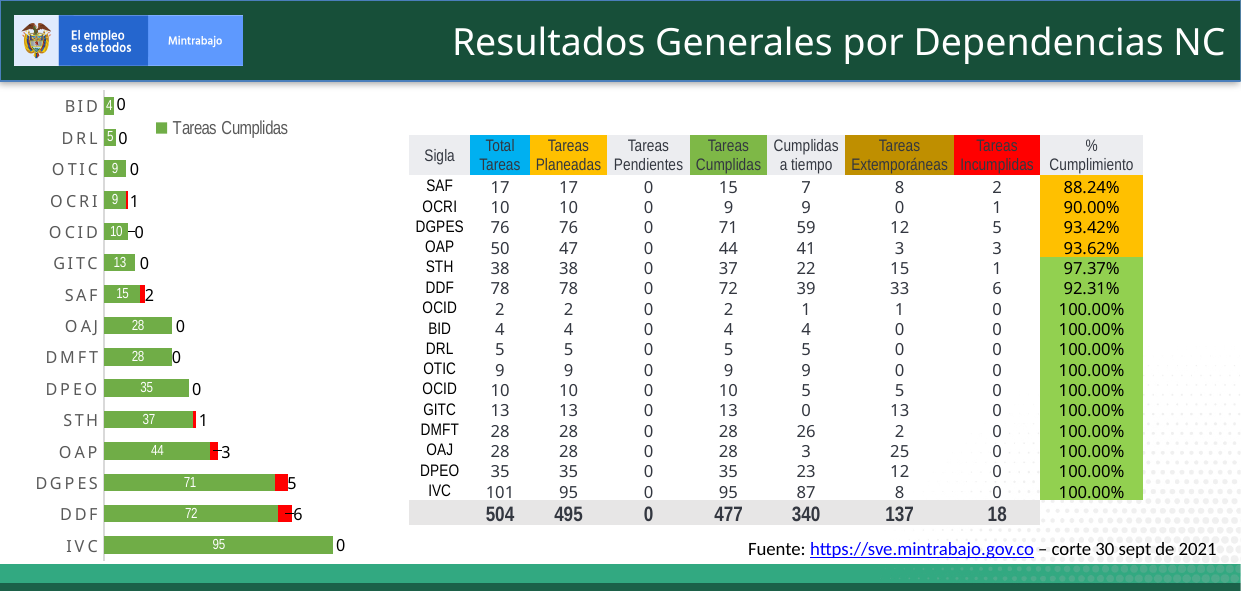
In the bar chart, what is the Tareas Cumplidas value for IVC? 95 In the bar chart, what is the Tareas Cumplidas value for STH? 37 How many series does the legend of the bar chart list? 1 In the bar chart, what is the value of the red segment for DDF? 6 What is the legend entry shown in the bar chart? Tareas Cumplidas In the bar chart, which category has the highest Tareas Cumplidas value? IVC What type of chart is shown on the left of the slide? bar chart In the bar chart, what is the difference between the Tareas Cumplidas values for IVC and DDF? 23 In the bar chart, which has a larger Tareas Cumplidas value, OAP or DPEO? OAP In the bar chart, which category has the lowest Tareas Cumplidas value? BID How many categories are shown in the bar chart? 15 In the bar chart, what is the Tareas Cumplidas value for DGPES? 71